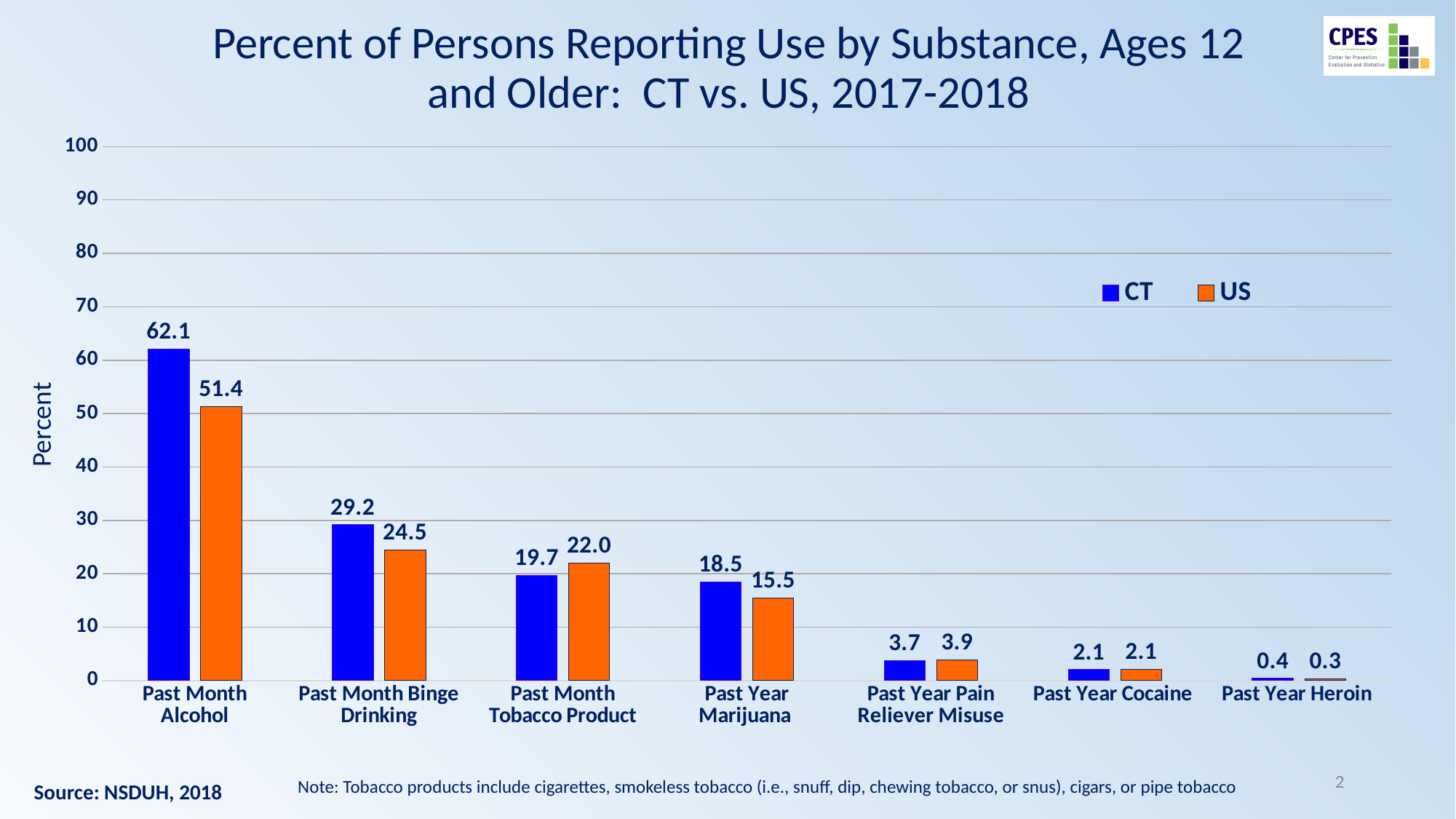
What colour are the US bars? orange What kind of chart is shown on the slide? bar chart Which substance category has the highest CT value? Past Month Alcohol What is the difference between the CT and US values for Past Month Alcohol? 10.7 Which is larger for Past Month Tobacco Product, the CT value or the US value? US What is the CT value for Past Year Marijuana? 18.5 What is the CT value for Past Month Alcohol? 62.1 Which substance category has the lowest US value? Past Year Heroin Is the CT value for Past Month Binge Drinking greater or less than 30? less What is the US value for Past Month Binge Drinking? 24.5 How many substance categories are shown on the x axis? 7 How many series does the legend list? 2